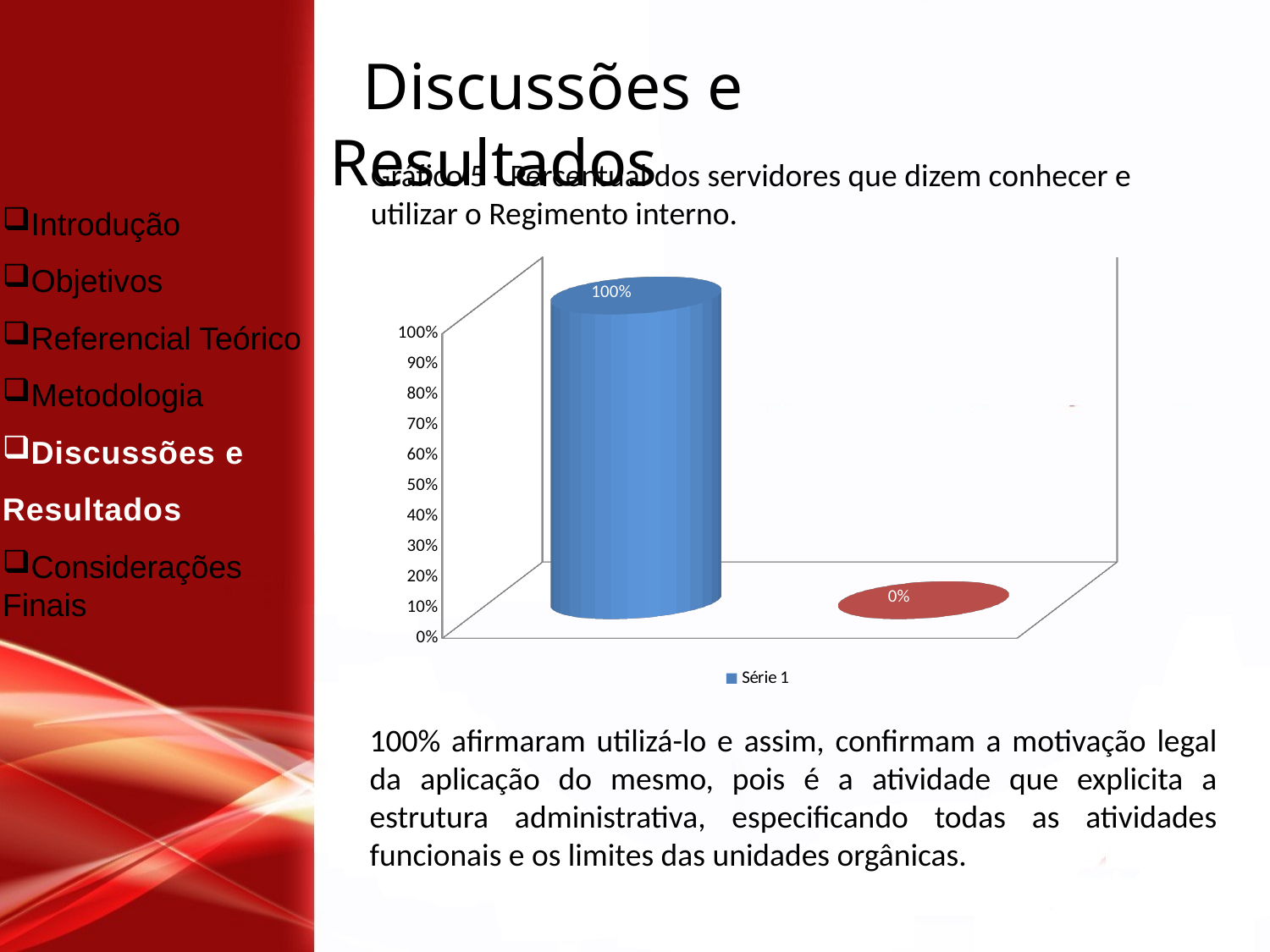
How many bars are plotted in the chart? 2 What is the highest value shown on the chart's vertical axis? 100% What value is labelled on the right (red) bar of the chart? 0% Do the values fall or rise from the left bar to the right bar? fall What kind of chart is shown on the slide? bar chart Is the value of the left (blue) bar greater or less than 50%? greater What value is labelled on the left (blue) bar of the chart? 100% What is the name of the series shown in the chart legend? Série 1 What is the lowest value labelled on any bar in the chart? 0% How many series does the chart legend list? 1 Which bar is higher, the left (blue) bar or the right (red) bar? the left (blue) bar What is the difference between the value of the left bar and the value of the right bar? 100%